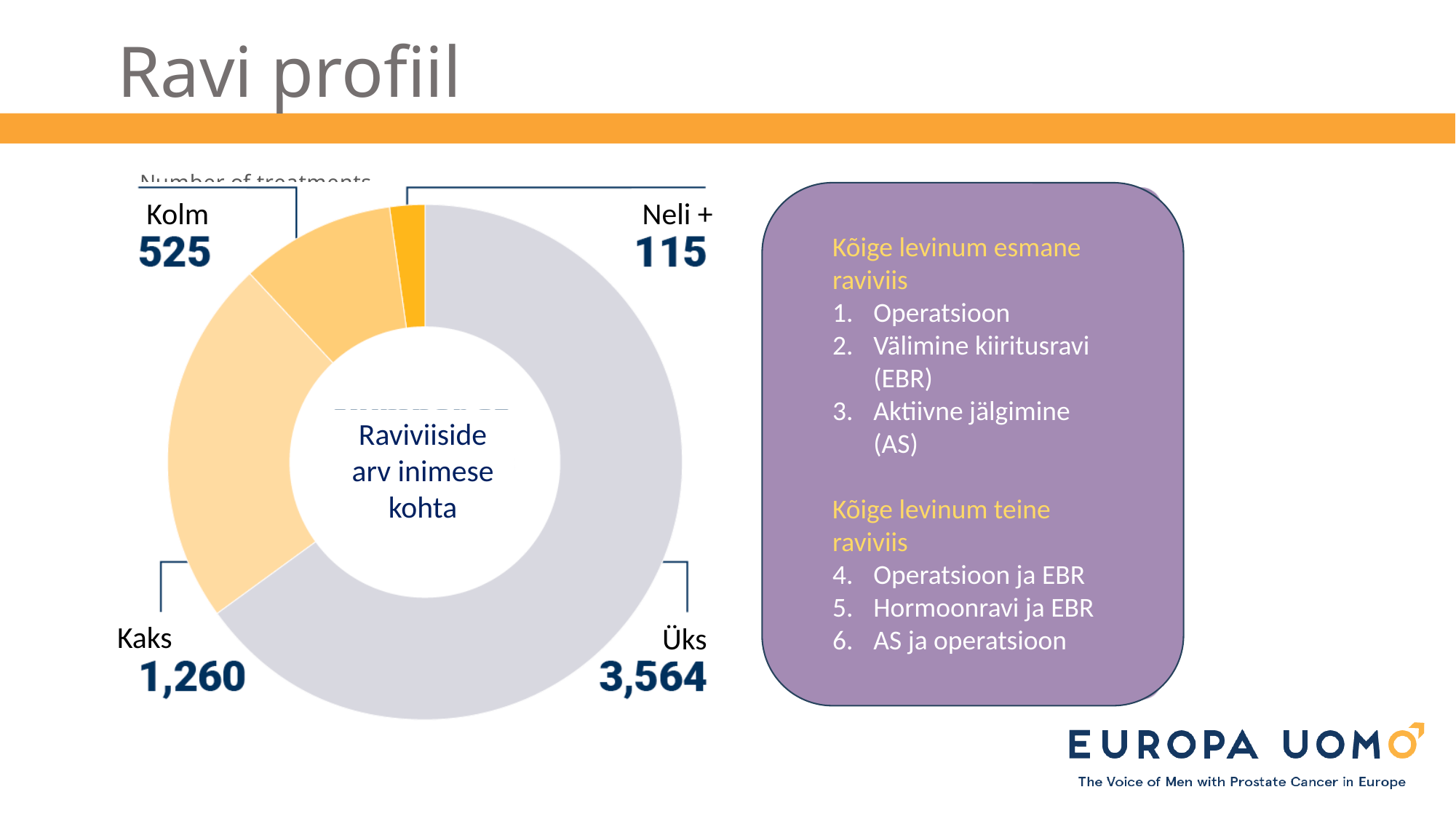
What is the value for Kolm in the donut chart? 525 What is the difference between the values for Kaks and Kolm? 735 What is the value for Üks in the donut chart? 3,564 Which category has the highest value in the donut chart? Üks What text is written in the centre of the donut chart? Raviviiside arv inimese kohta Which is larger, the value for Kolm or the value for Neli +? Kolm What is the value for Neli + in the donut chart? 115 What kind of chart is shown on the slide? pie chart (donut) What is the difference between the values for Üks and Kaks? 2,304 What is the value for Kaks in the donut chart? 1,260 Which category has the lowest value in the donut chart? Neli + How many categories are shown in the donut chart? 4